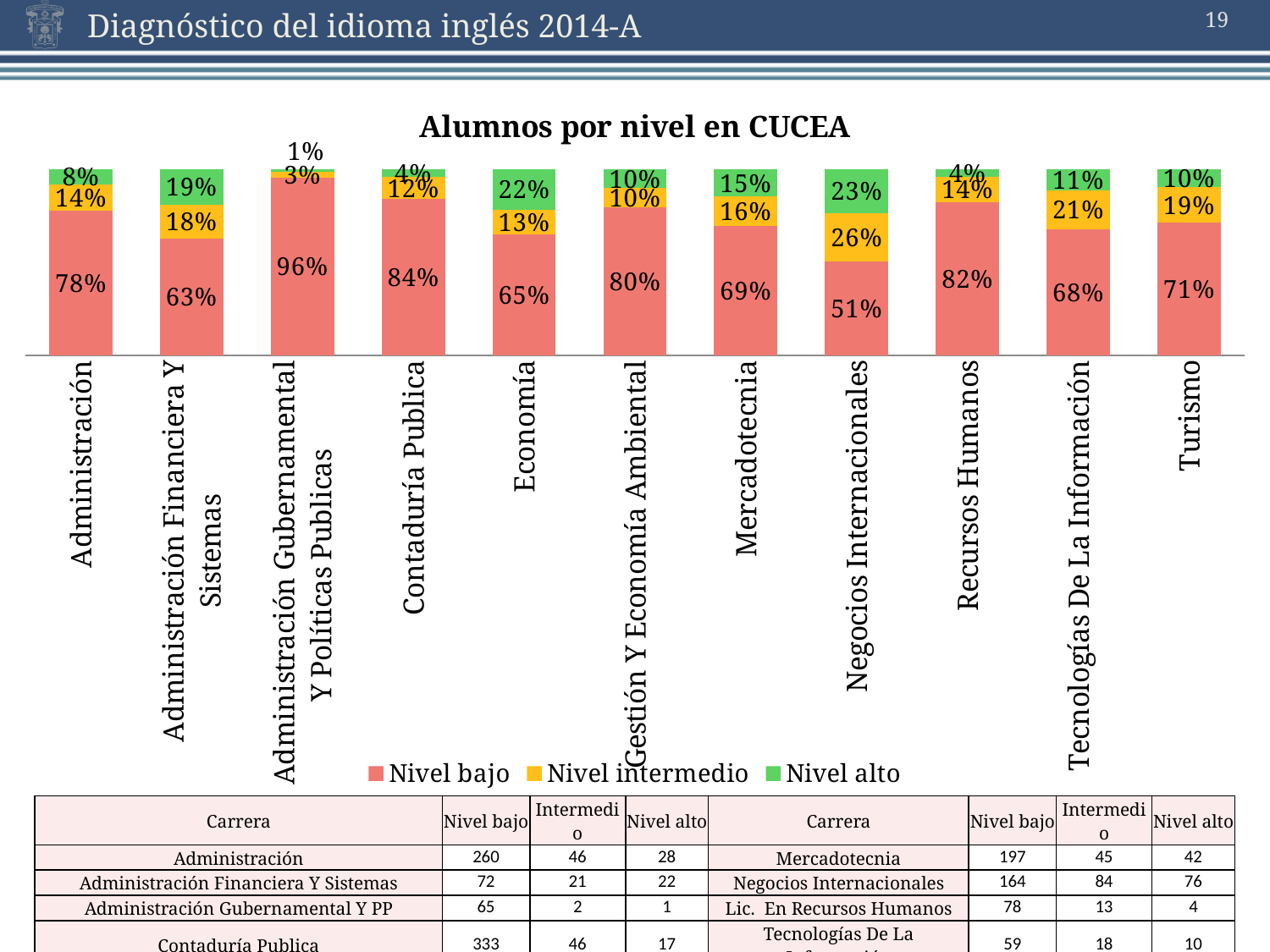
Which carrera has the highest Nivel bajo percentage? Administración Gubernamental Y Políticas Publicas How many series does the legend list? 3 What kind of chart is shown on the slide? Stacked bar chart What is the Nivel alto value for Economía? 22% What is the Nivel intermedio value for Tecnologías De La Información? 21% How many carreras are shown on the x axis of the chart? 11 What is the title of the chart? Alumnos por nivel en CUCEA What is the Nivel bajo value for Negocios Internacionales? 51% Which has a larger Nivel intermedio value, Mercadotecnia or Negocios Internacionales? Negocios Internacionales Which carrera has the highest Nivel alto percentage? Negocios Internacionales What is the difference between the Nivel bajo values for Contaduría Publica and Turismo? 13% Which carrera has the lowest Nivel bajo percentage? Negocios Internacionales